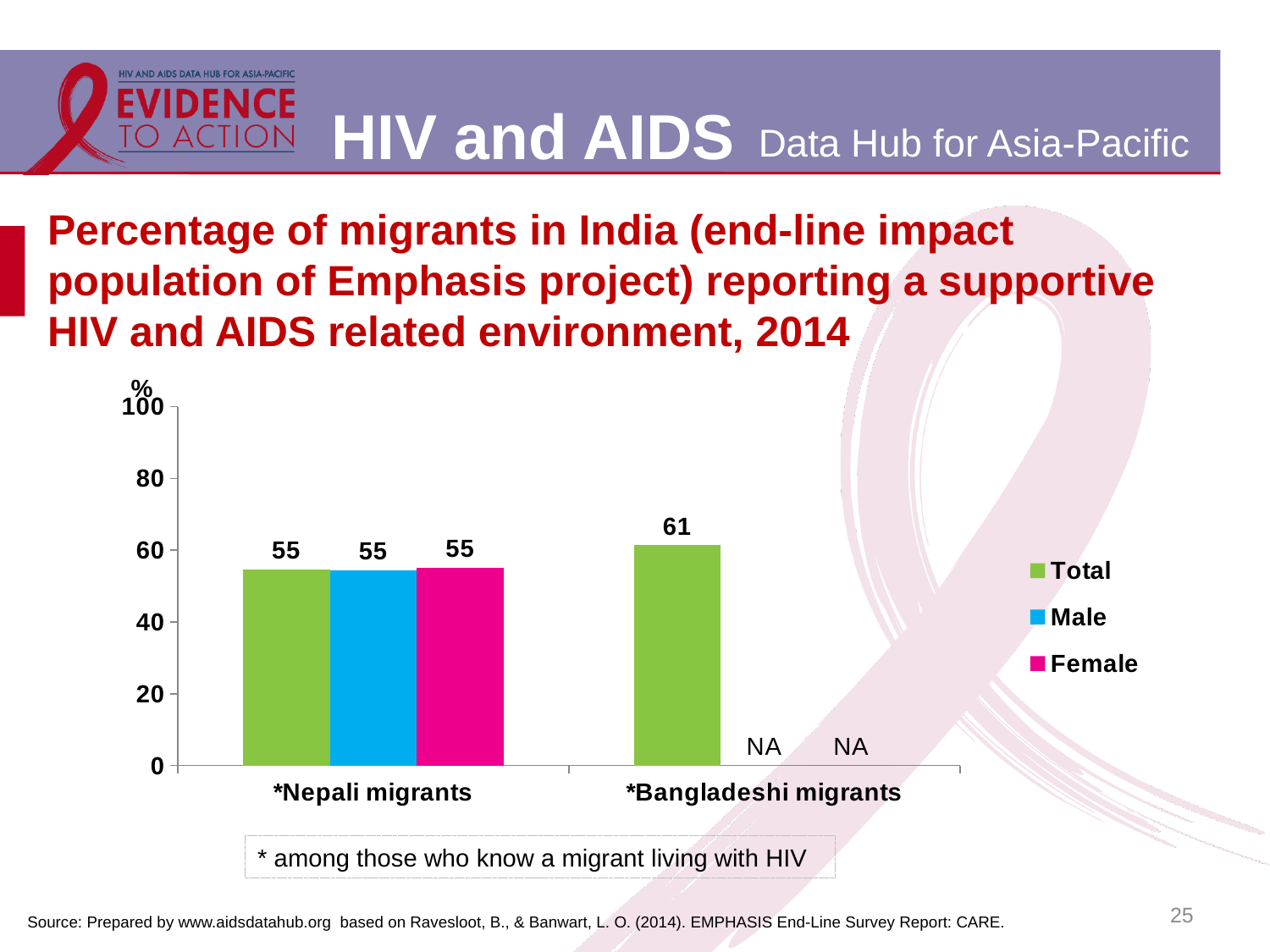
Which category has the higher Total value, Nepali migrants or Bangladeshi migrants? Bangladeshi migrants What is the difference between the Total value for Bangladeshi migrants and the Total value for Nepali migrants? 6 What is the Total value for Bangladeshi migrants? 61 What colour represents the Female series in the legend? pink What is the Total value for Nepali migrants? 55 Is the Total value for Bangladeshi migrants greater or less than 60? greater What kind of chart is shown on the slide? bar chart How many categories are shown on the x axis? 2 What is the Female value for Nepali migrants? 55 Is the Male value for Nepali migrants greater or less than 60? less How many series does the legend list? 3 What is shown for the Male value for Bangladeshi migrants? NA